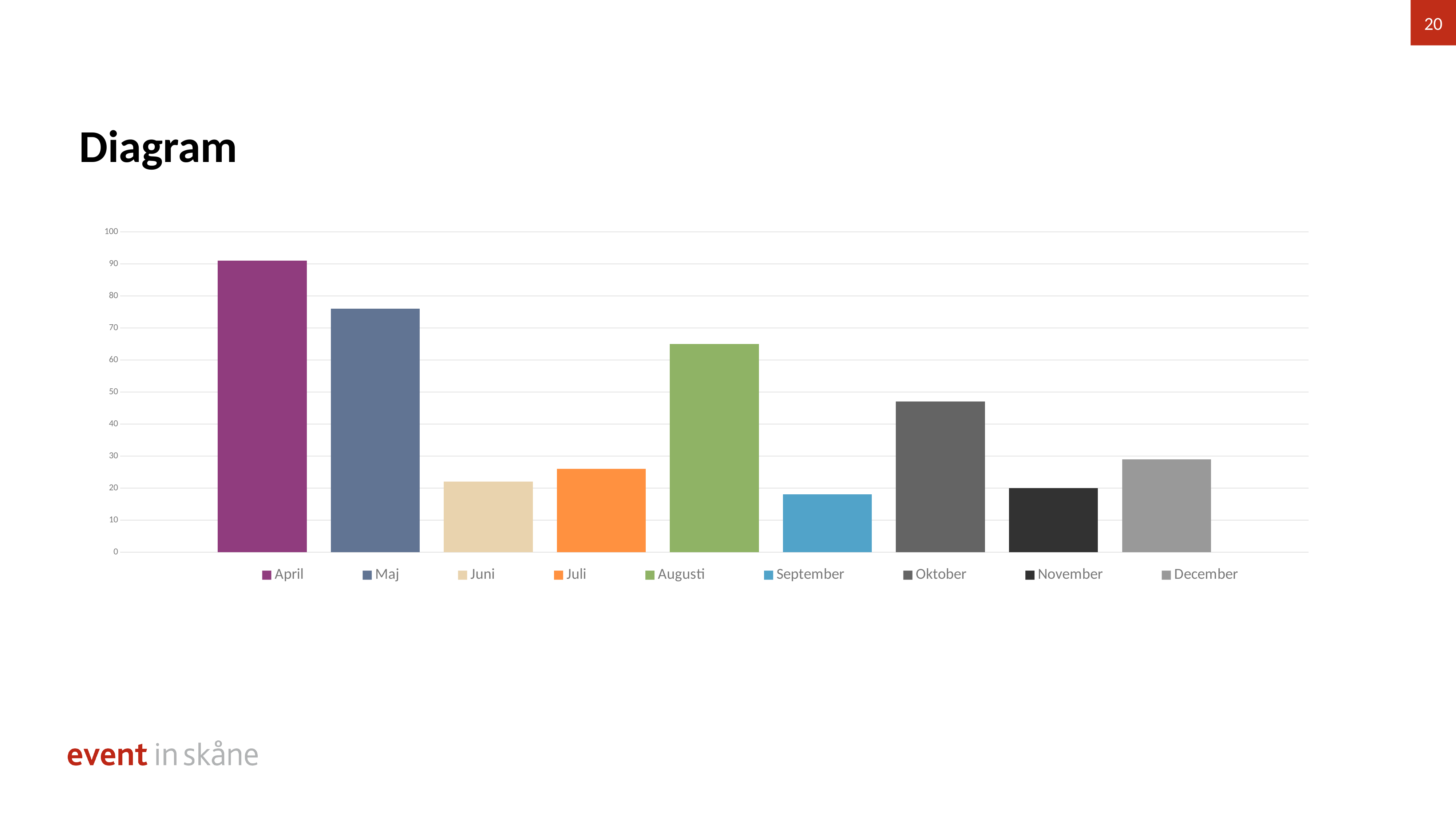
Is the value for Oktober greater or less than 50? less Is the value for Juli greater or less than 30? less Which is larger, the value for Juli or the value for Juni? Juli Is the value for Maj greater or less than 70? greater What kind of chart is shown on the slide? bar chart How many series does the legend list? 9 What is the title of the slide containing the chart? Diagram How many bars are plotted in the chart? 9 Which is larger, the value for Augusti or the value for Oktober? Augusti Which month has the highest bar? April